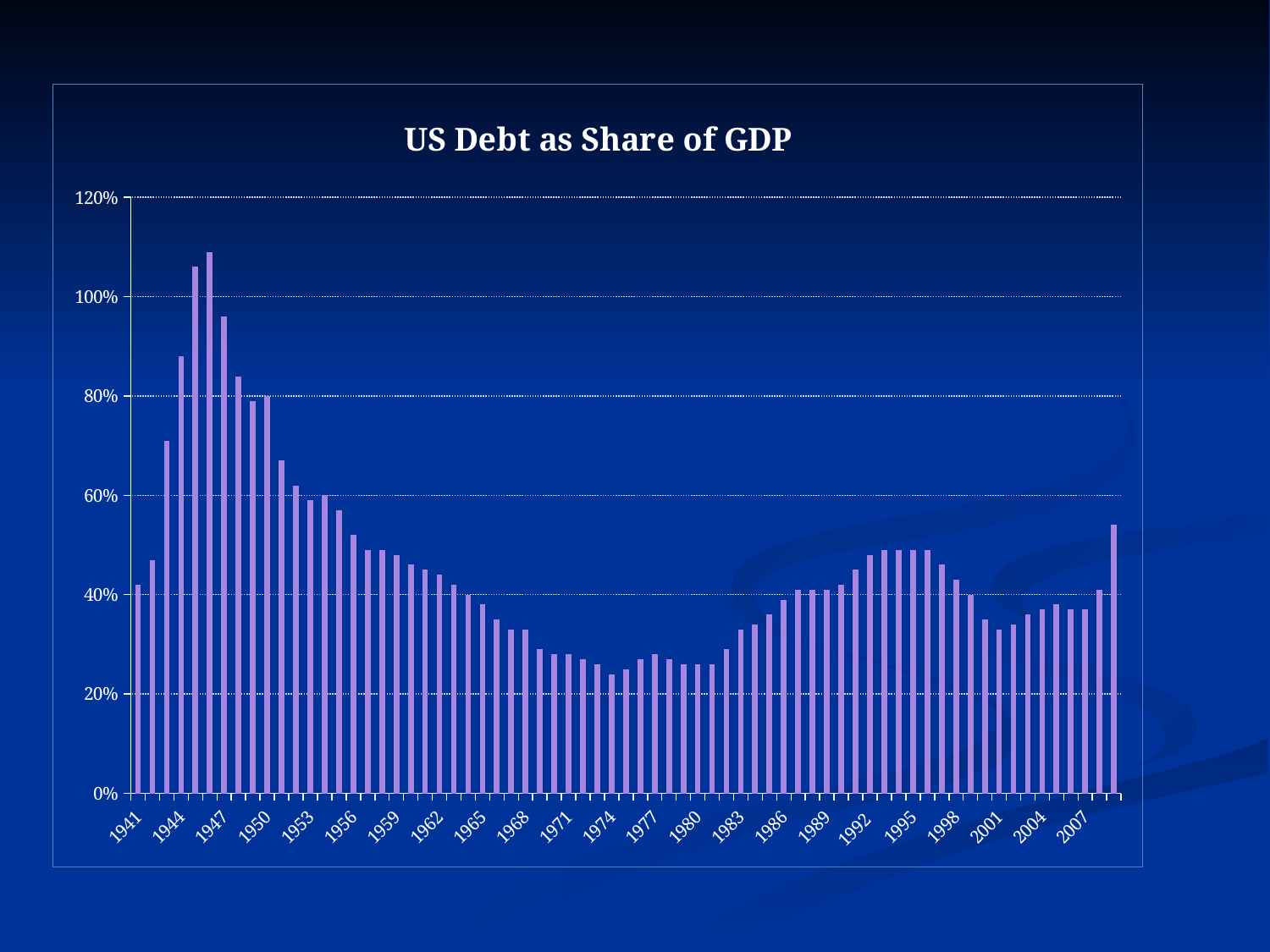
Is the value for 1971 greater or less than 20%? greater Do the values generally rise or fall from 1947 to 1974? fall What is the title of the chart? US Debt as Share of GDP Is the value for 1968 greater or less than 40%? less Is the tallest bar in the chart greater or less than 100%? greater Which year has the larger value, 1944 or 1980? 1944 What is the highest value shown on the vertical axis? 120% What kind of chart is shown on the slide? bar chart